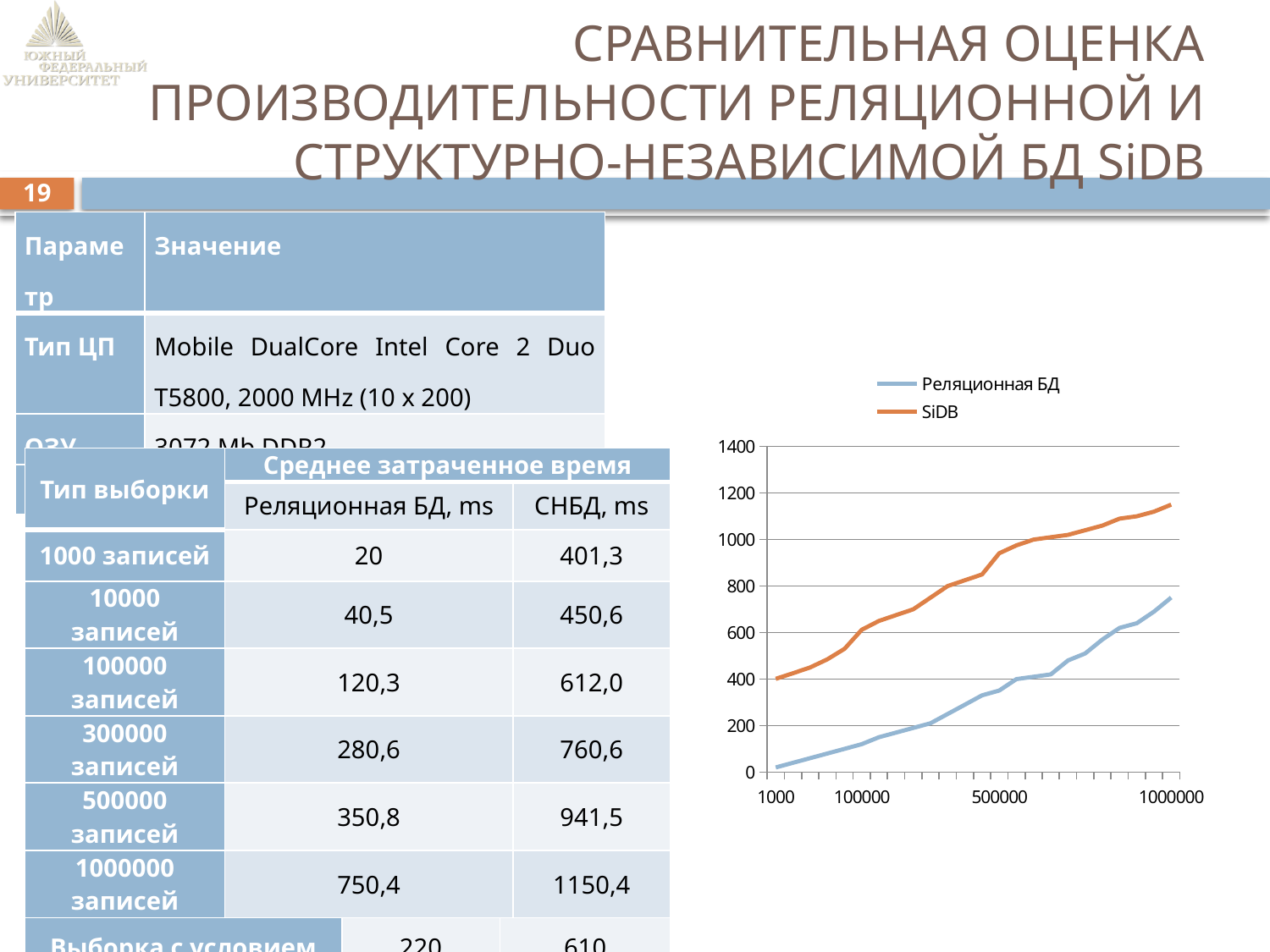
Do the values of the Реляционная БД line rise or fall along the x axis? rise How many series does the chart legend list? 2 Is the value of the SiDB line at 1000000 greater or less than 1000? greater Which series is drawn in orange on the chart? SiDB Which series is drawn in blue on the chart? Реляционная БД What kind of chart is shown on the slide? line chart Is the value of the SiDB line at 500000 greater or less than 800? greater Which series has the higher value at 1000000 on the x axis, SiDB or Реляционная БД? SiDB Do the values of the SiDB line rise or fall as the x axis goes from 1000 to 1000000? rise Is the value of the Реляционная БД line at 1000 greater or less than 200? less